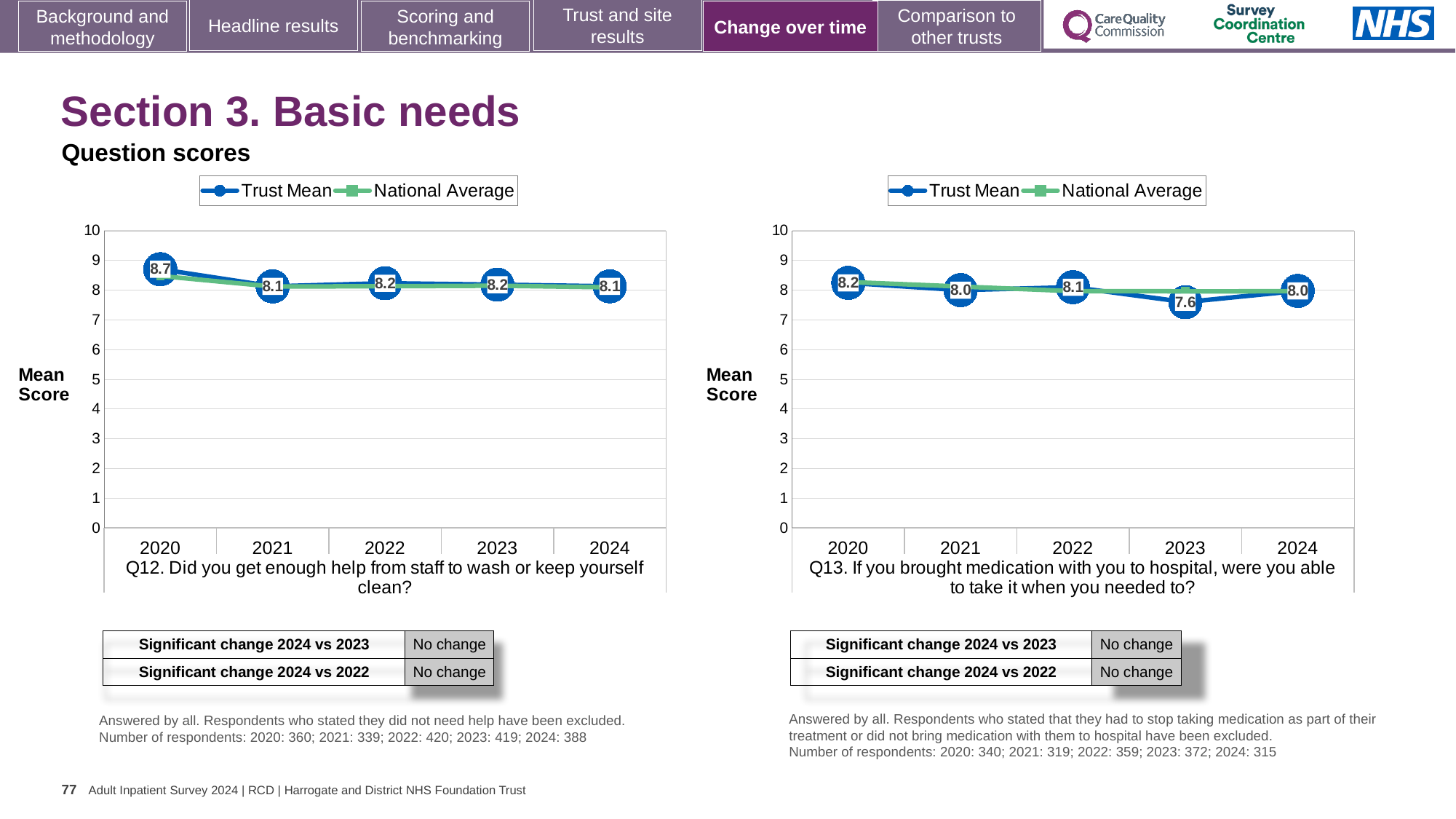
On the Q12 chart, which year has the highest Trust Mean? 2020 On the Q13 chart, is the Trust Mean for 2020 larger or smaller than the Trust Mean for 2021? larger On the Q13 chart, what is the difference between the Trust Mean for 2020 and 2023? 0.6 On the Q12 chart, what is the Trust Mean for 2024? 8.1 On the Q13 chart, which year has the lowest Trust Mean? 2023 On the Q12 chart, what is the Trust Mean for 2020? 8.7 On the Q12 chart, what is the difference between the Trust Mean for 2020 and 2021? 0.6 On the Q13 chart, what is the Trust Mean for 2023? 7.6 How many series does the legend of the Q12 chart list? 2 What kind of chart is the Q13 chart? Line chart On the Q12 chart, how many years are plotted on the x axis? 5 On the Q13 chart, is the Trust Mean for 2023 greater or less than 8? less